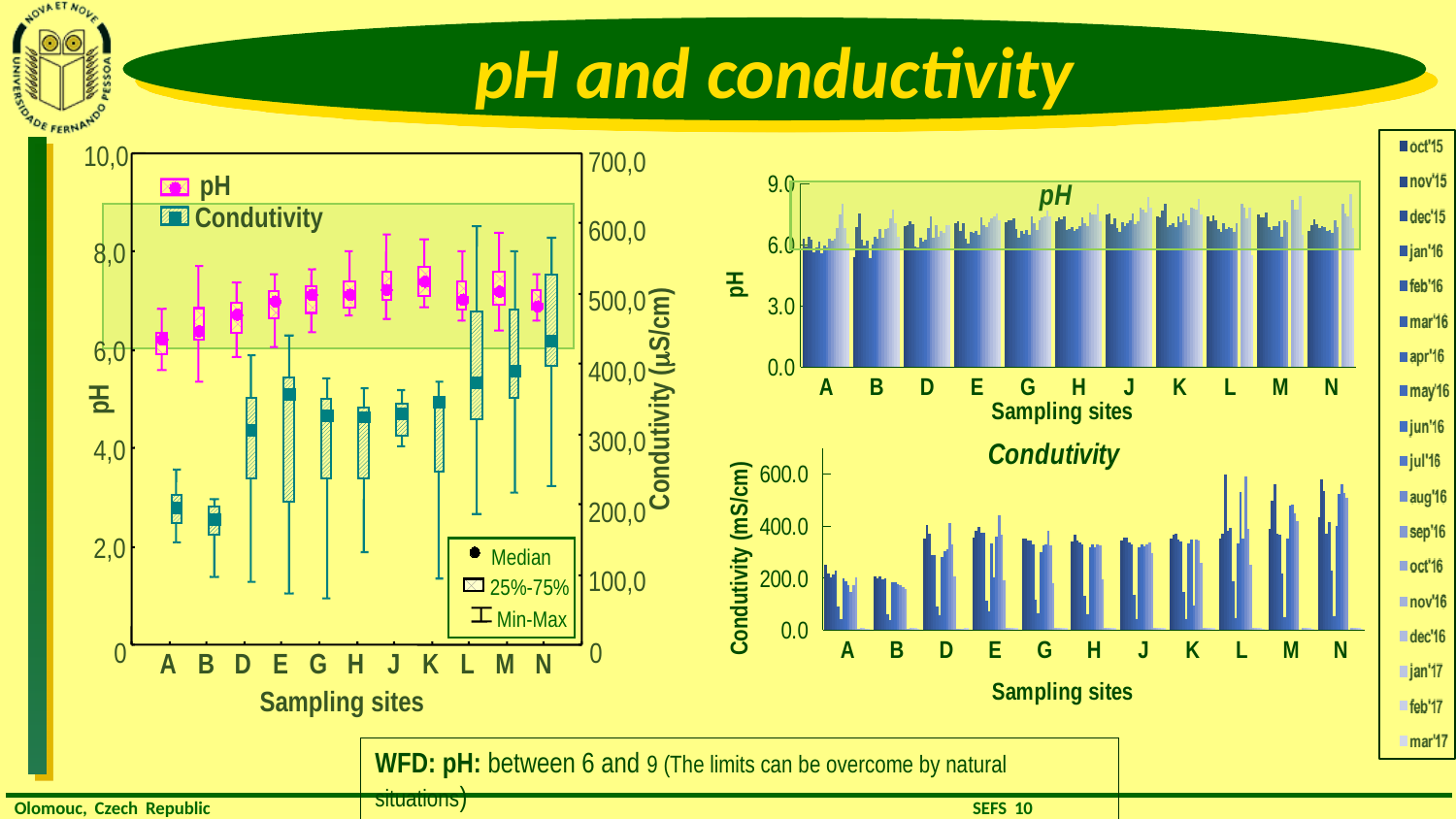
In the pH bar chart on the top right, are the values for site A greater or less than 9.0? less In the left box plot, is the median pH for site A greater or less than 7,0? less What is the label of the right-hand y axis of the left box plot? Condutivity (µS/cm) How many months does the legend on the right side of the slide list? 18 What is the first month listed in the legend on the right side of the slide? oct'15 In the Conductivity bar chart on the bottom right, are the values for site B greater or less than 400.0? less In the left box plot, how many series does the legend at the top list? 2 What kind of chart is the Conductivity chart on the bottom right? bar chart How many sampling sites are shown on the x axis of the Conductivity bar chart on the bottom right? 11